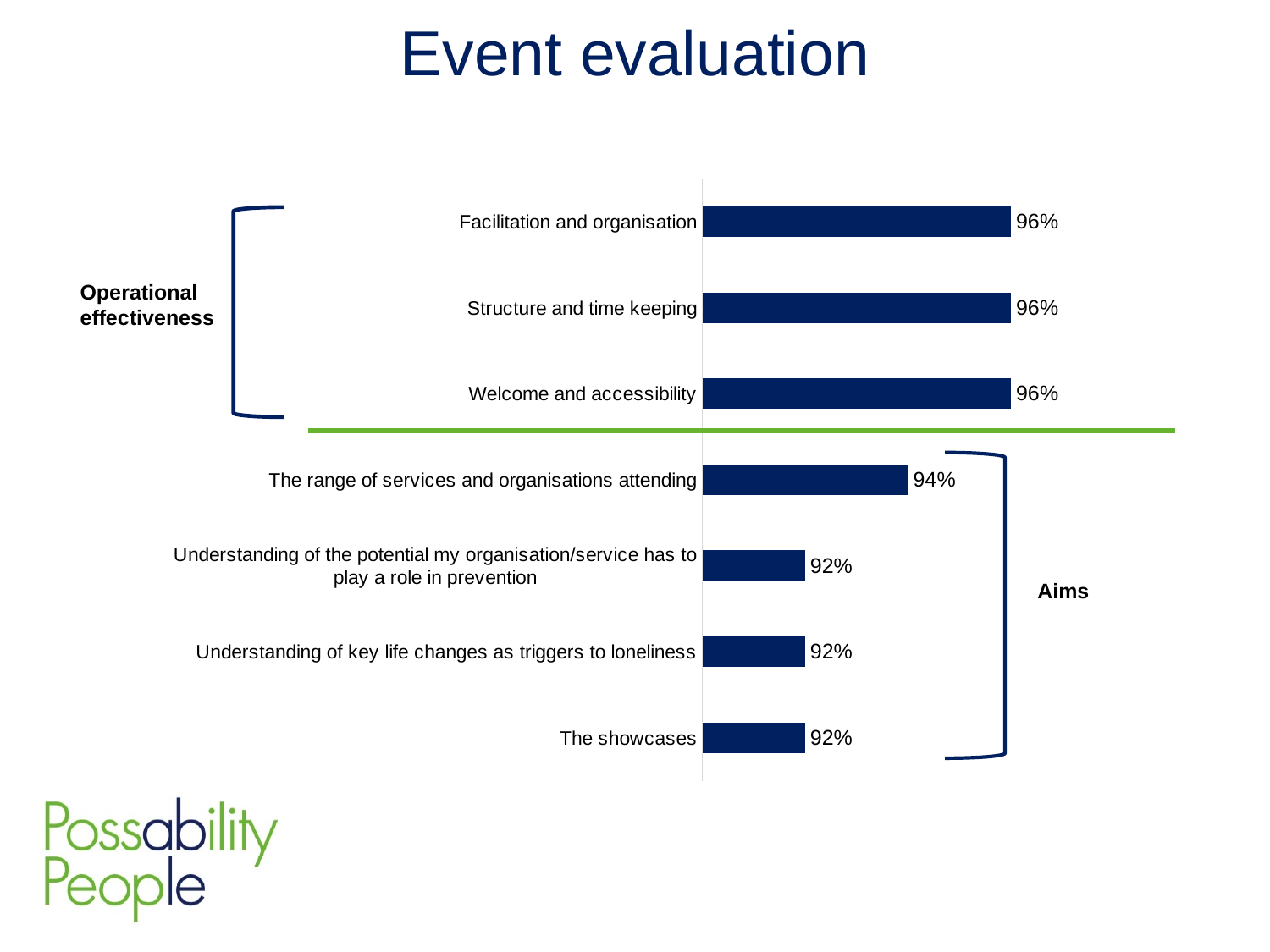
What kind of chart is shown on the slide? Bar chart What is the value for Understanding of key life changes as triggers to loneliness? 92% What is the difference between the value for Welcome and accessibility and the value for The showcases? 4% What is the lowest value shown in the chart? 92% Which is larger, the value for Structure and time keeping or the value for The range of services and organisations attending? Structure and time keeping What is the difference between the value for The range of services and organisations attending and the value for Understanding of the potential my organisation/service has to play a role in prevention? 2% What is the highest value shown in the chart? 96% What is the value for Facilitation and organisation? 96% What is the value for The range of services and organisations attending? 94% What is the value for The showcases? 92% How many categories are shown in the chart? 7 What is the title of the slide containing the chart? Event evaluation